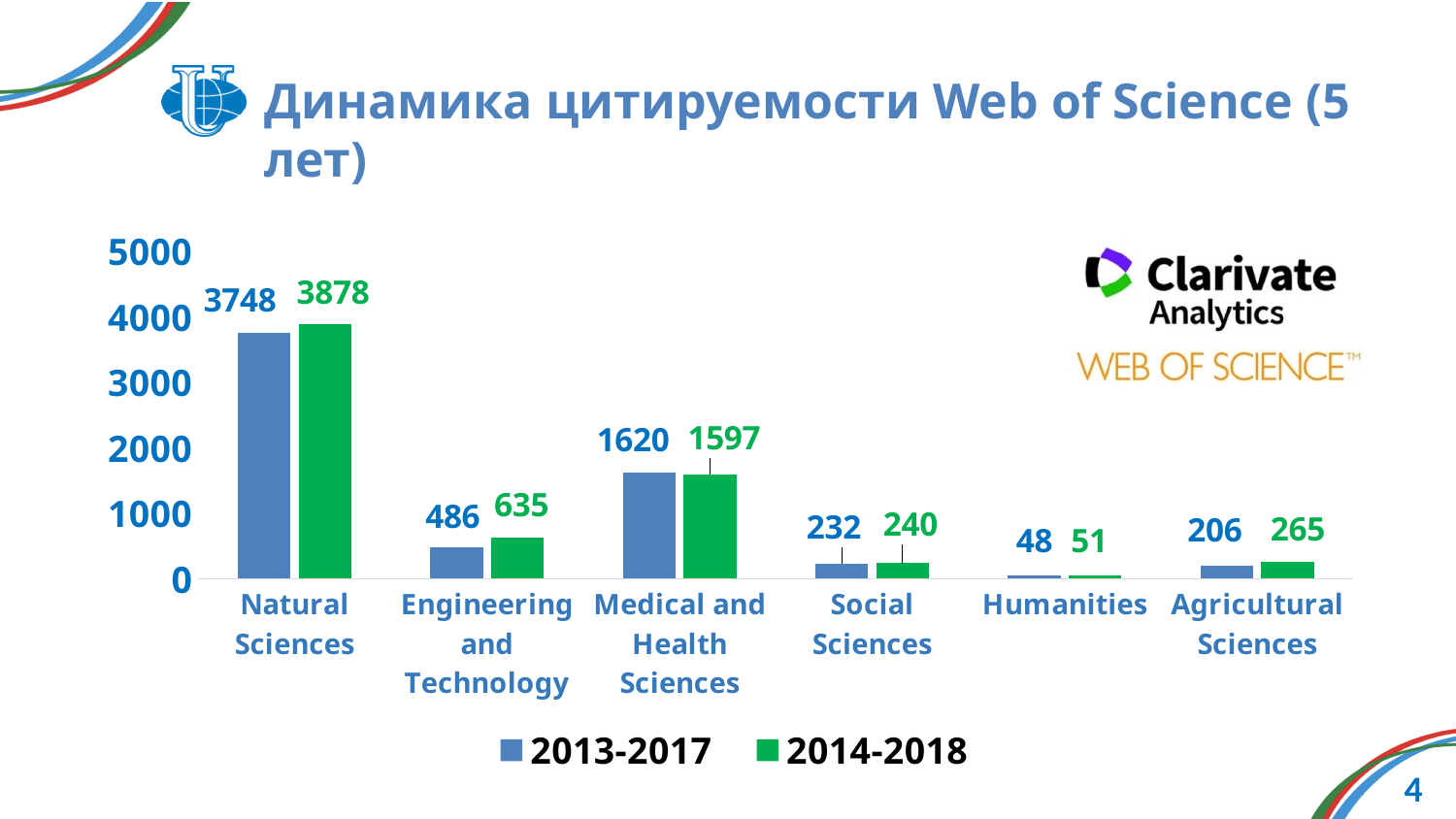
How many categories are shown on the x axis? 6 Which category has the highest value in the 2013-2017 series? Natural Sciences Which is larger for Agricultural Sciences: the 2013-2017 value or the 2014-2018 value? 2014-2018 Which category has the lowest value in the 2014-2018 series? Humanities What is the value for Humanities in the 2014-2018 series? 51 How many series does the legend list? 2 What is the value for Engineering and Technology in the 2013-2017 series? 486 What is the difference between the 2014-2018 and 2013-2017 values for Engineering and Technology? 149 What is the difference between the 2013-2017 and 2014-2018 values for Medical and Health Sciences? 23 What is the value for Natural Sciences in the 2014-2018 series? 3878 What kind of chart is shown on the slide? bar chart Is the 2013-2017 value for Medical and Health Sciences greater or less than 2000? less